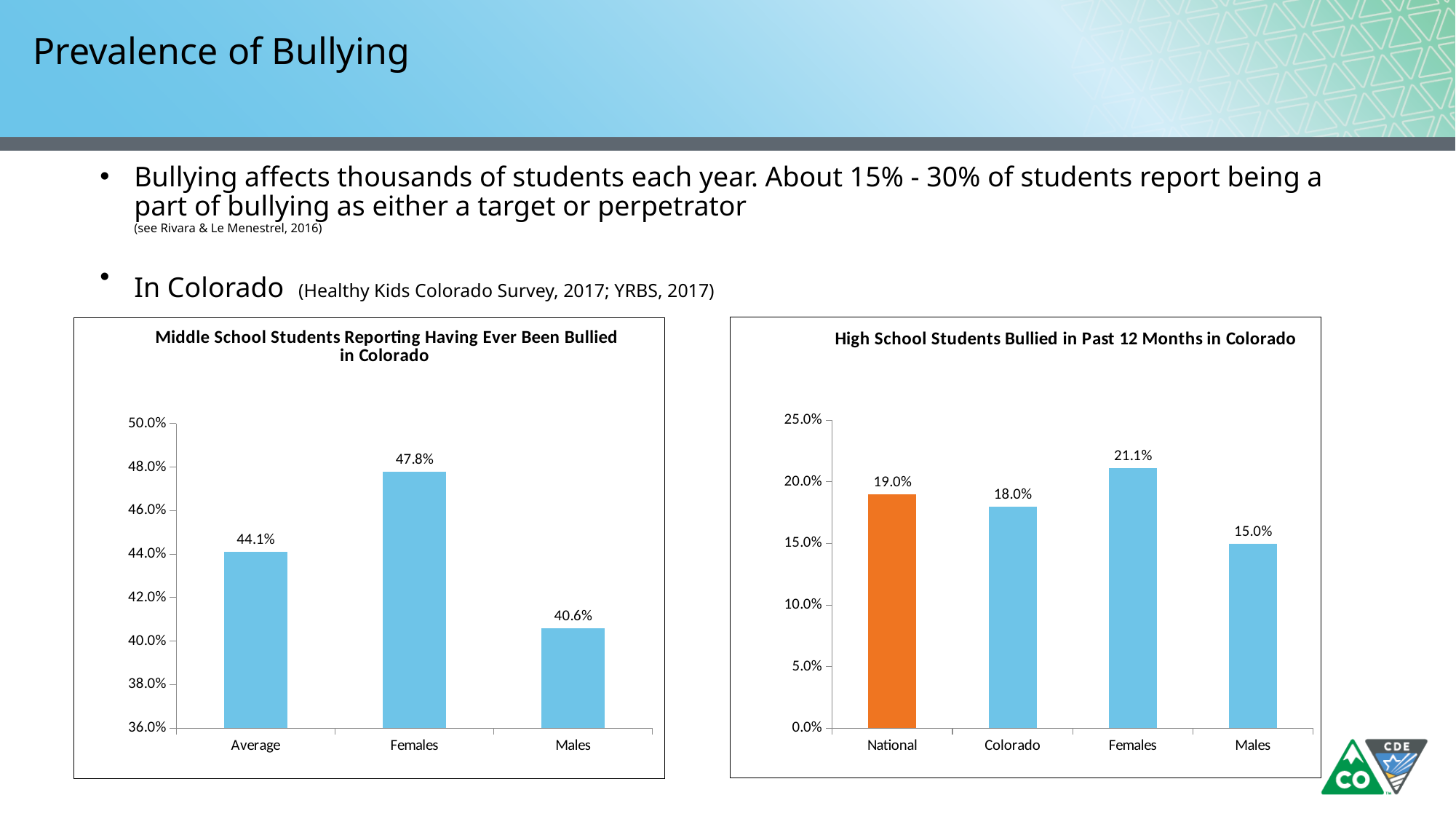
In the 'High School Students Bullied in Past 12 Months in Colorado' chart, which is larger, the value for National or the value for Colorado? National In the 'Middle School Students Reporting Having Ever Been Bullied in Colorado' chart, what is the difference between the Females and Males values? 7.2% In the 'High School Students Bullied in Past 12 Months in Colorado' chart, what is the difference between the Females and Males values? 6.1% In the 'Middle School Students Reporting Having Ever Been Bullied in Colorado' chart, which category has the lowest value? Males In the 'High School Students Bullied in Past 12 Months in Colorado' chart, what is the value for Colorado? 18.0% In the 'High School Students Bullied in Past 12 Months in Colorado' chart, which bar is coloured orange? National In the 'High School Students Bullied in Past 12 Months in Colorado' chart, which category has the highest value? Females What kind of chart is the 'High School Students Bullied in Past 12 Months in Colorado' chart? Bar chart In the 'Middle School Students Reporting Having Ever Been Bullied in Colorado' chart, how many categories are shown? 3 In the 'Middle School Students Reporting Having Ever Been Bullied in Colorado' chart, what is the value for Females? 47.8% In the 'Middle School Students Reporting Having Ever Been Bullied in Colorado' chart, what is the value for Males? 40.6% In the 'High School Students Bullied in Past 12 Months in Colorado' chart, what is the value for National? 19.0%